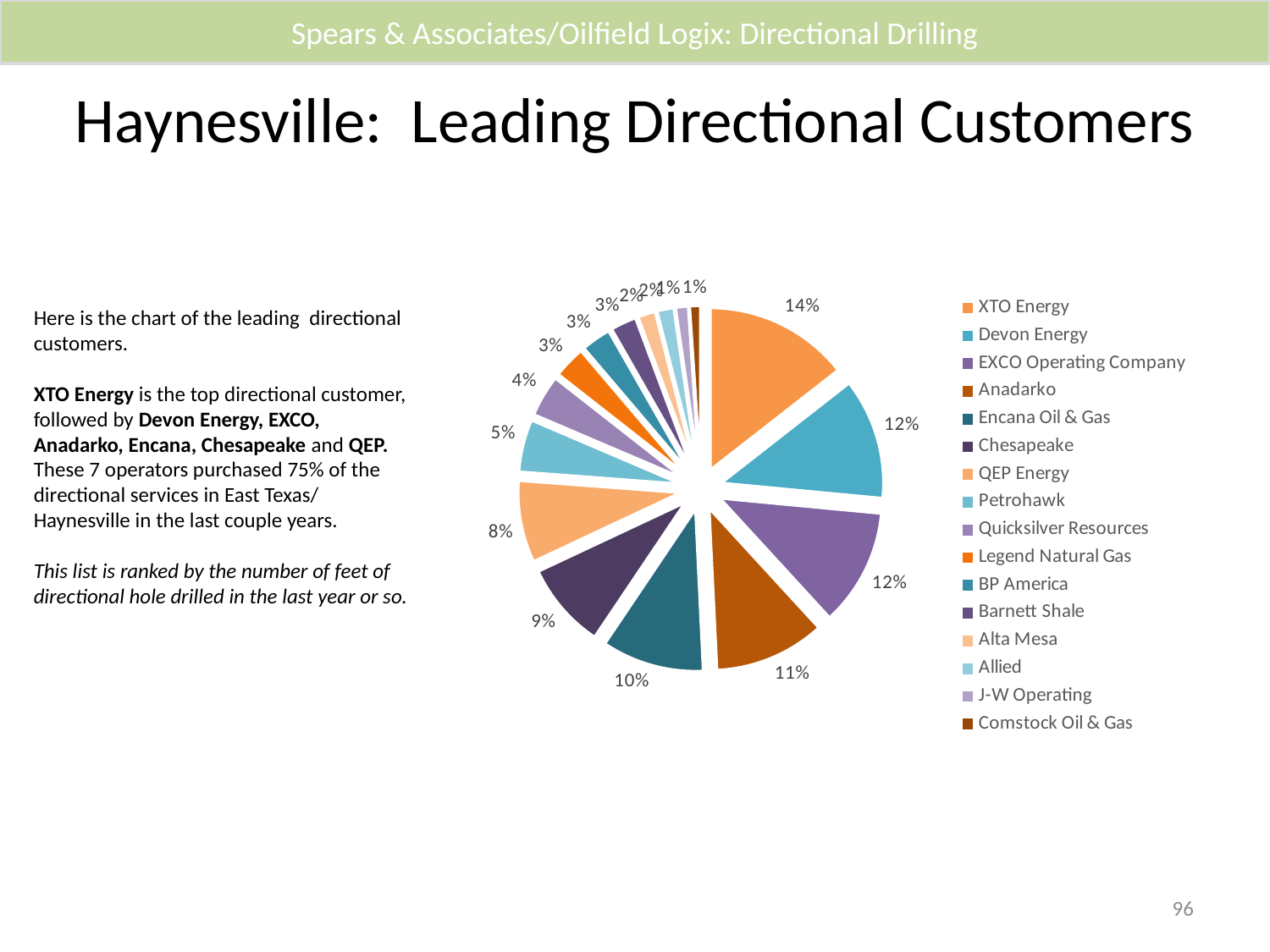
What colour is the XTO Energy slice in the pie chart? orange What percentage is shown for Anadarko? 11% What percentage is shown for Petrohawk? 5% What is the difference in percentage points between XTO Energy's share and Anadarko's share? 3 percentage points How many customers does the legend of the pie chart list? 16 Which customer has the largest slice of the pie? XTO Energy What percentage is shown for Chesapeake? 9% What share of the pie does XTO Energy hold? 14% What percentage is shown for QEP Energy? 8% What percentage is shown for Encana Oil & Gas? 10% What kind of chart is shown on the slide? pie chart Which has the larger share, Petrohawk or Quicksilver Resources? Petrohawk